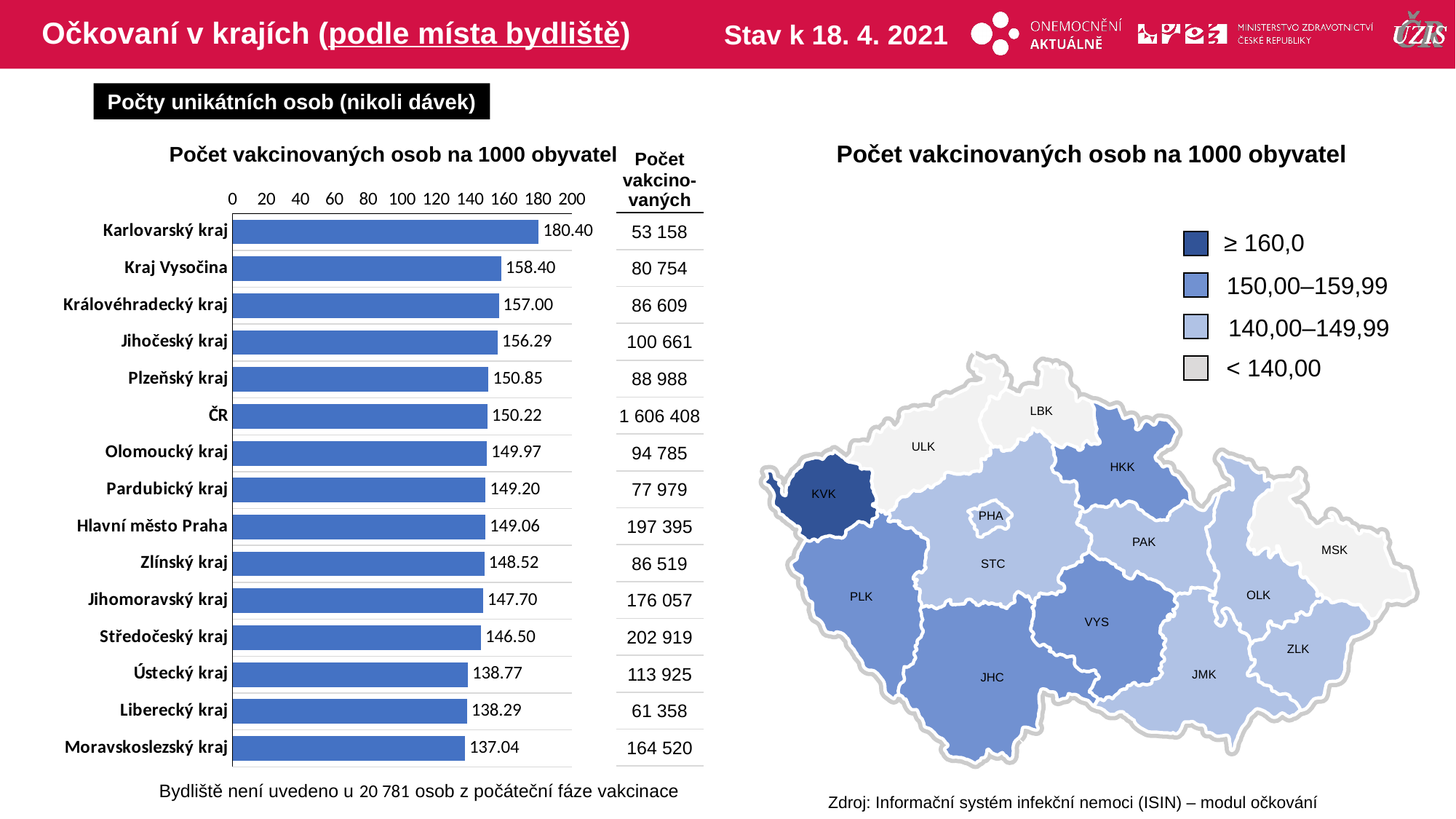
In the bar chart, which has the larger value, Jihočeský kraj or Plzeňský kraj? Jihočeský kraj In the bar chart, which category has the highest value? Karlovarský kraj In the bar chart, do the values rise or fall going from the top category to the bottom category? fall In the bar chart, is the value for Ústecký kraj greater or less than 140? less In the bar chart, what is the difference between the values for Karlovarský kraj and Moravskoslezský kraj? 43.36 How many categories are shown in the bar chart? 15 What kind of chart is shown on the left of the slide? bar chart In the bar chart, what is the value for Karlovarský kraj? 180.40 In the bar chart, what is the value for Hlavní město Praha? 149.06 In the bar chart, which category has the lowest value? Moravskoslezský kraj How many categories does the legend of the map on the right list? 4 In the bar chart, what is the value for ČR? 150.22